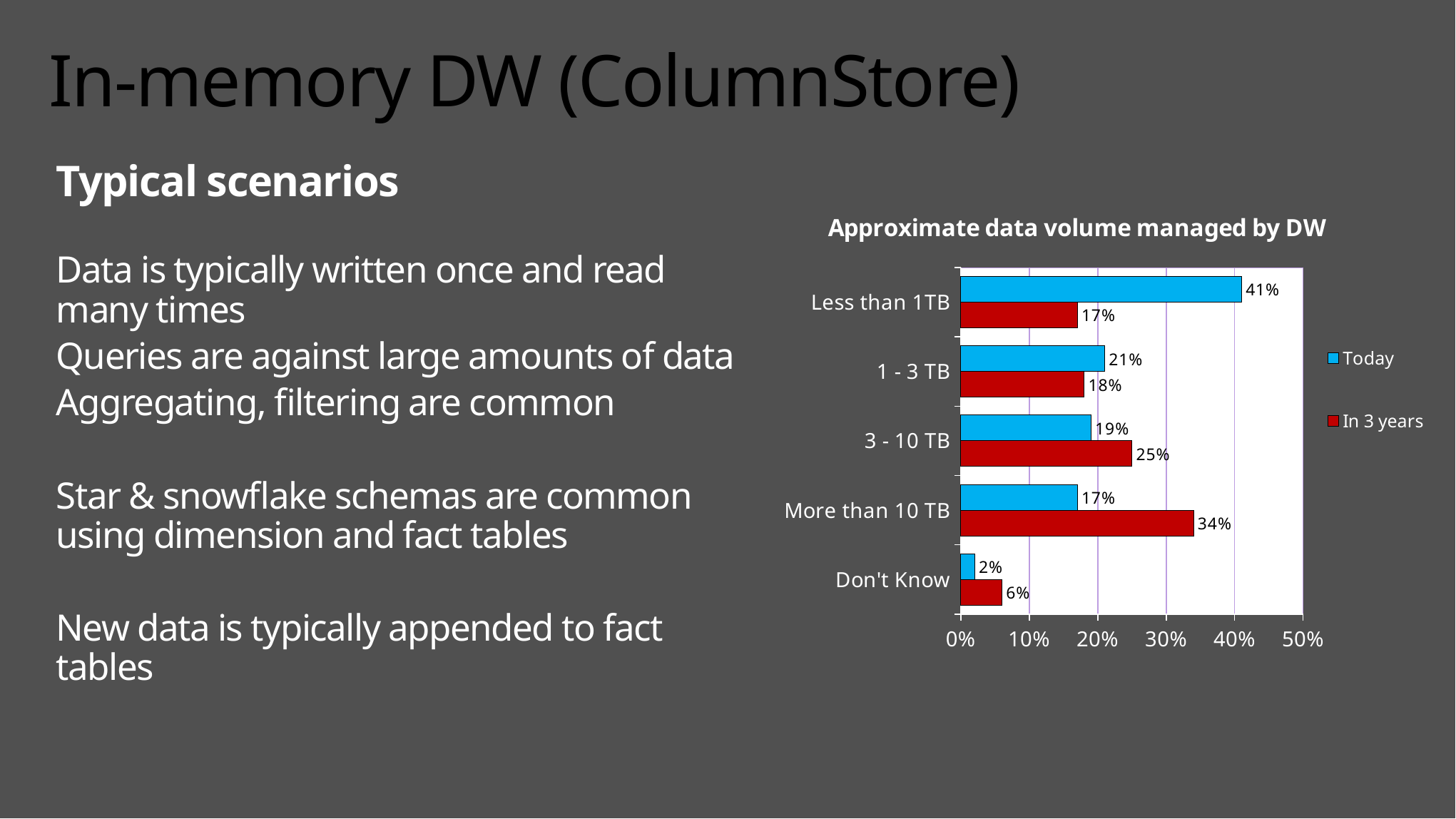
What is the difference between the 'Today' and 'In 3 years' values for 'Less than 1TB'? 24% Which category has the highest 'Today' value? Less than 1TB How many series does the legend list? 2 What is the 'In 3 years' value for 'More than 10 TB'? 34% How many categories are shown on the chart? 5 What kind of chart is shown on the slide? Bar chart Which category has the lowest 'In 3 years' value? Don't Know Which is larger for 'More than 10 TB': the 'Today' value or the 'In 3 years' value? In 3 years What is the 'Today' value for 'Less than 1TB'? 41% Which colour represents the 'In 3 years' series? Red What is the title of the chart? Approximate data volume managed by DW What is the 'In 3 years' value for '3 - 10 TB'? 25%